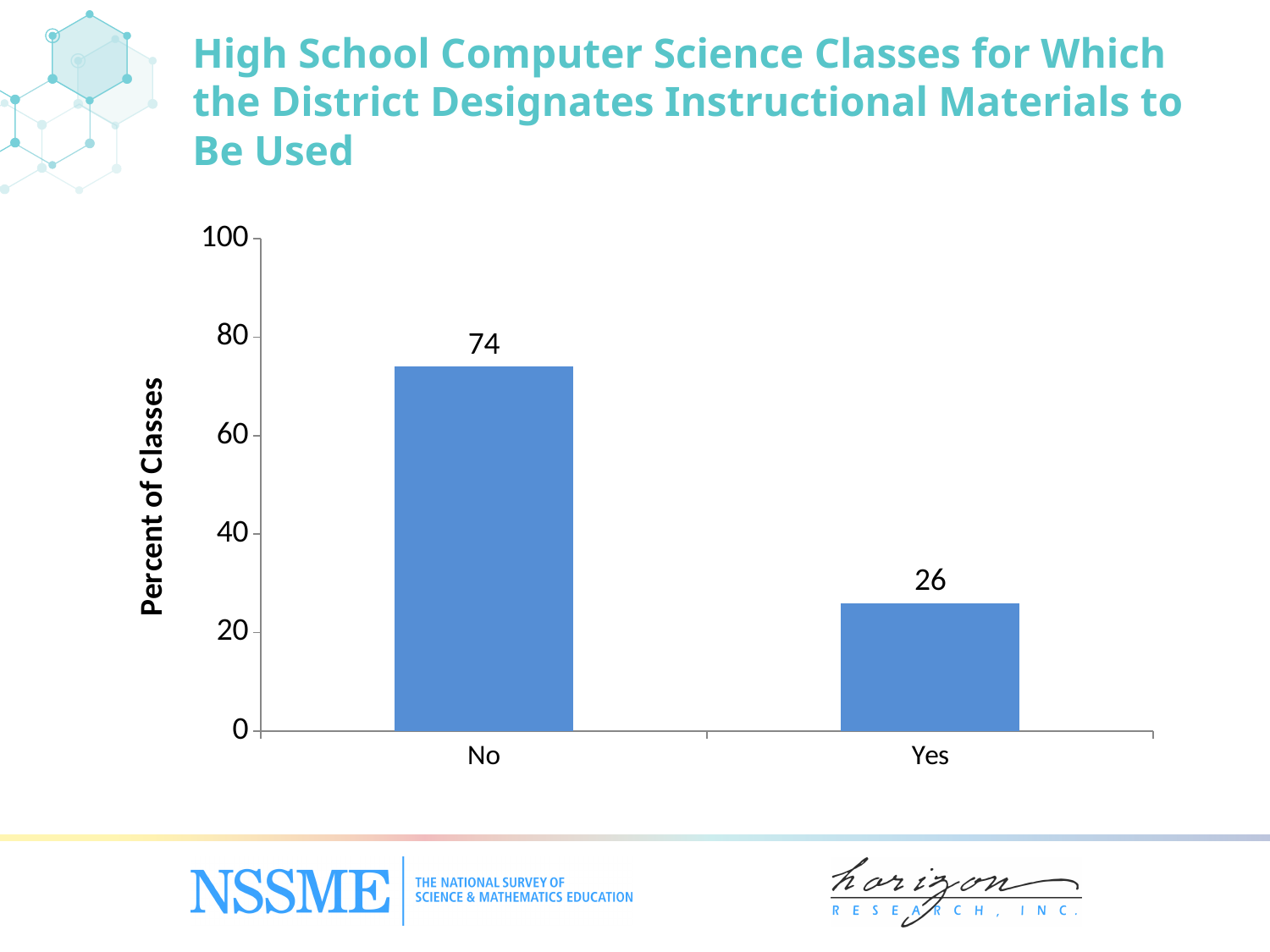
What is the value for "No"? 74 Is the value for "No" greater or less than 60? greater What is the maximum value shown on the y axis? 100 What is the label of the y axis? Percent of Classes Is the value for "Yes" greater or less than 40? less Which category has the lowest value? Yes Which category has the highest value? No What is the difference between the values for "No" and "Yes"? 48 Which is larger, the value for "No" or the value for "Yes"? No How many categories are shown on the x axis? 2 What kind of chart is shown on the slide? bar chart What is the value for "Yes"? 26